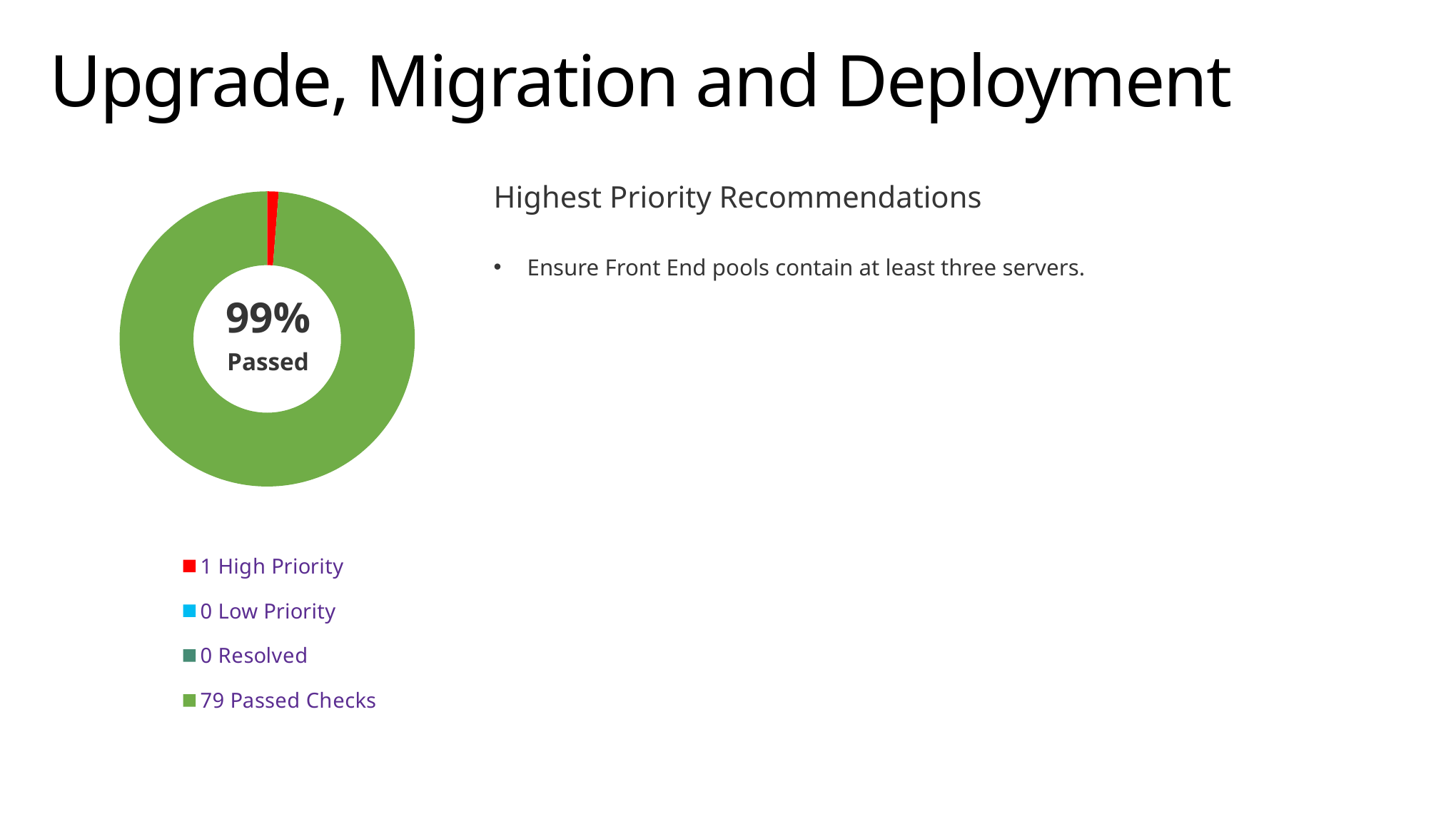
How many Passed Checks does the legend show? 79 How many entries does the legend list? 4 What kind of chart is shown on the slide? Doughnut chart What percentage is shown in the centre of the doughnut chart? 99% Which is larger, the number of High Priority items or the number of Passed Checks? Passed Checks How many High Priority items does the legend show? 1 What is the difference between the number of Passed Checks and the number of High Priority items? 78 How many Resolved items does the legend show? 0 How many Low Priority items does the legend show? 0 What is the total of all the counts listed in the legend? 80 Which category has the highest count? Passed Checks What colour represents Passed Checks in the chart? Green